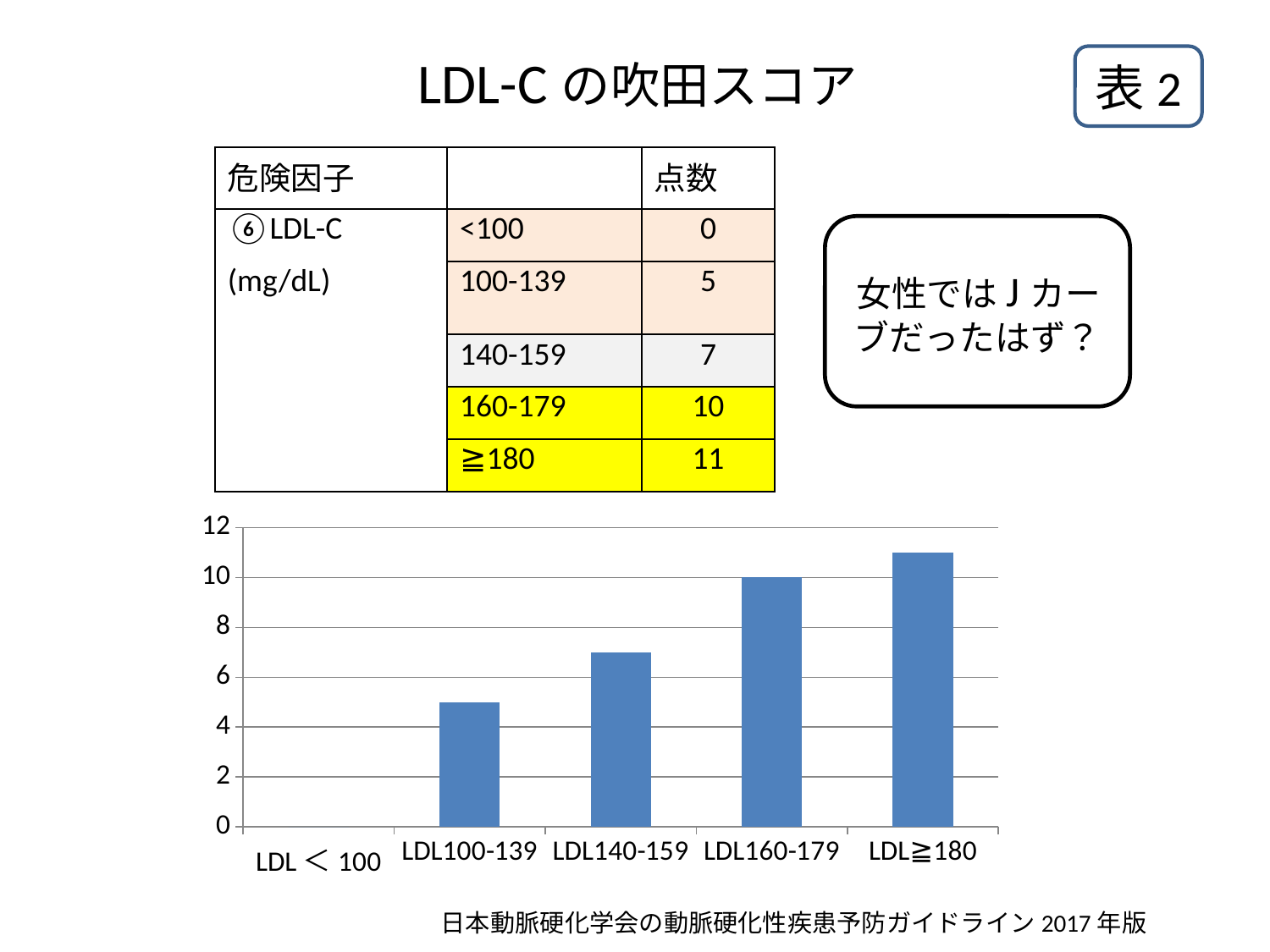
Which category has the lowest value in the chart? LDL＜100 Is the value for LDL≧180 greater or less than 10? greater What is the value for LDL＜100 in the chart? 0 Which is larger, the value for LDL160-179 or the value for LDL100-139? LDL160-179 Is the value for LDL140-159 greater or less than 8? less Is the value for LDL100-139 greater or less than 4? greater How many categories are plotted on the x axis of the chart? 5 What is the value for LDL160-179 in the chart? 10 Which category has the highest bar in the chart? LDL≧180 What kind of chart is shown on the slide? bar chart Do the values rise or fall from left to right along the x axis? rise What is the difference between the value for LDL160-179 and the value for LDL＜100? 10